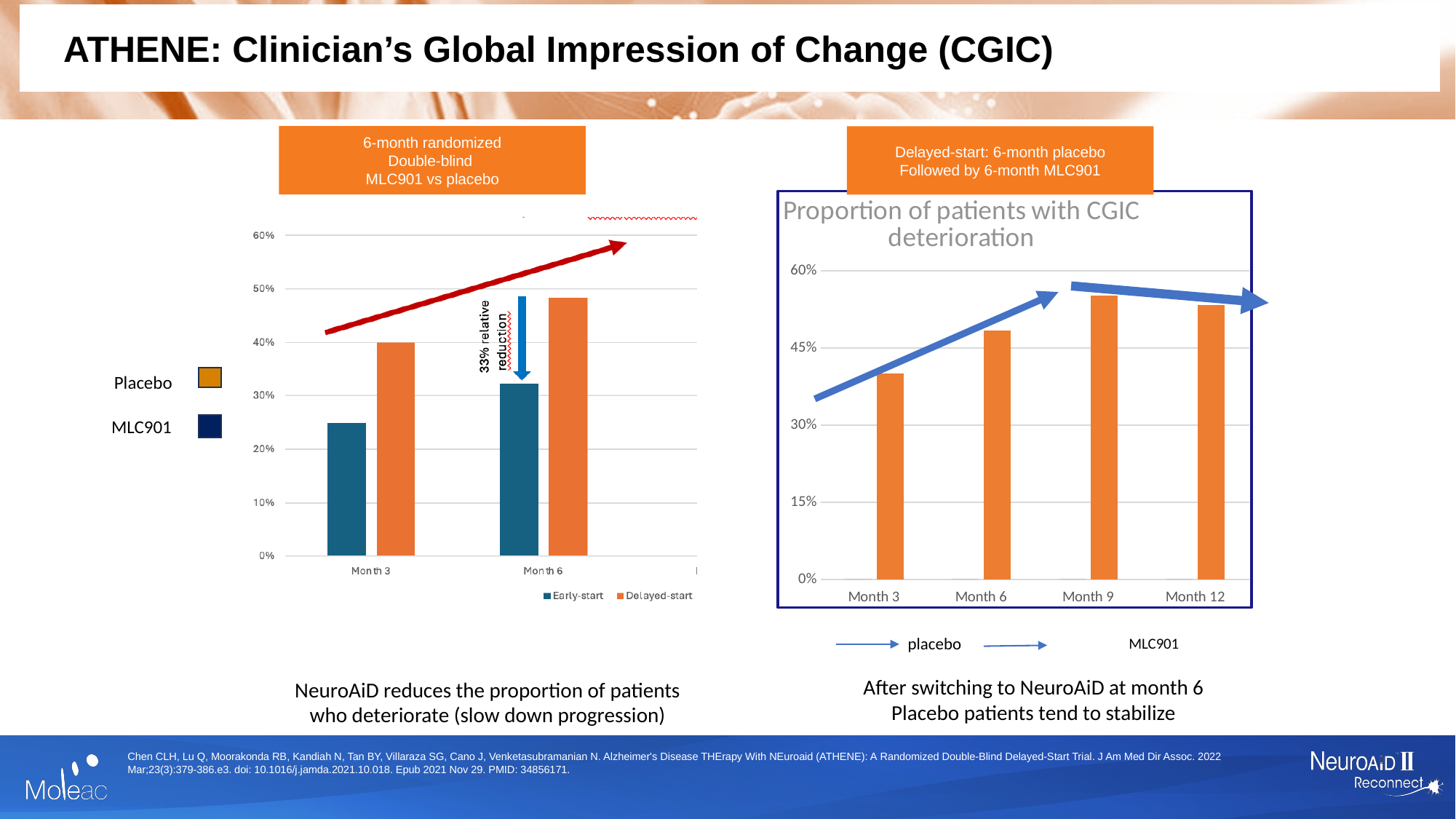
What is the title of the right chart? Proportion of patients with CGIC deterioration How many series does the legend of the left chart list? 2 In the left chart, is the Delayed-start value at Month 6 greater or less than 40%? greater What type of chart is the left chart? bar chart In the left chart, which series has the larger value at Month 6, Early-start or Delayed-start? Delayed-start In the left chart, does the Early-start series rise or fall from Month 3 to Month 6? rise How many categories are shown on the x axis of the chart titled 'Proportion of patients with CGIC deterioration'? 4 In the chart titled 'Proportion of patients with CGIC deterioration', is the value for Month 3 greater or less than 45%? less In the chart titled 'Proportion of patients with CGIC deterioration', is the value for Month 9 greater or less than 45%? greater In the chart titled 'Proportion of patients with CGIC deterioration', which month has the lowest value? Month 3 In the chart titled 'Proportion of patients with CGIC deterioration', which is larger, the value for Month 6 or the value for Month 9? Month 9